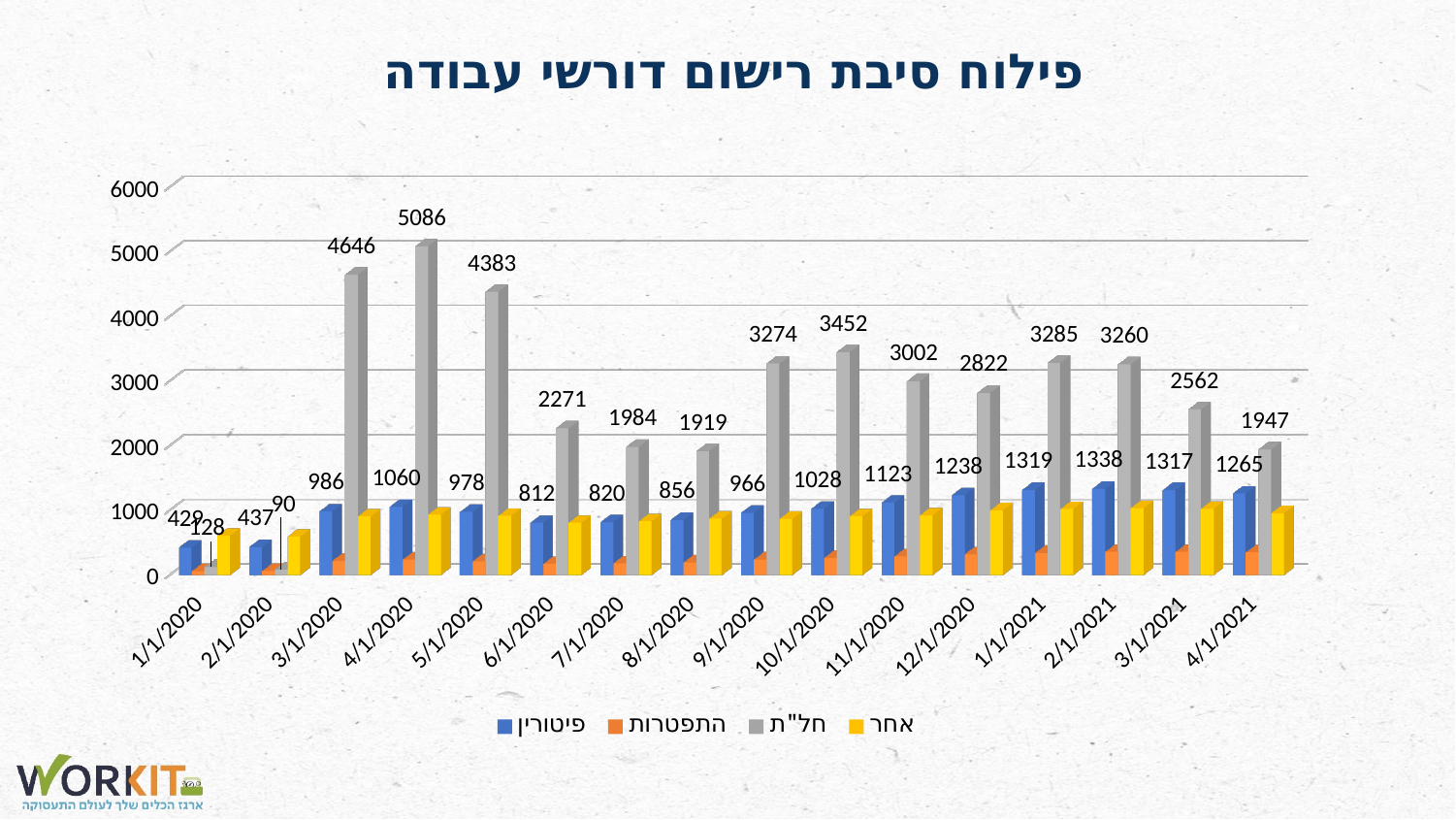
What is the value of the פיטורין series for 2/1/2021? 1338 How many series does the legend list? 4 What is the value of the חל"ת series for 4/1/2020? 5086 What kind of chart is shown on the slide? bar chart Which month has the highest value for the חל"ת series? 4/1/2020 Which month has the lowest value for the פיטורין series? 1/1/2020 How many months are shown on the x axis? 16 What is the difference between the חל"ת values for 4/1/2020 and 5/1/2020? 703 Which is larger, the חל"ת value for 9/1/2020 or for 10/1/2020? 10/1/2020 Is the value of the אחר series for 1/1/2021 greater or less than 2000? less Which month has the lowest value for the חל"ת series? 2/1/2020 What is the value of the חל"ת series for 4/1/2021? 1947